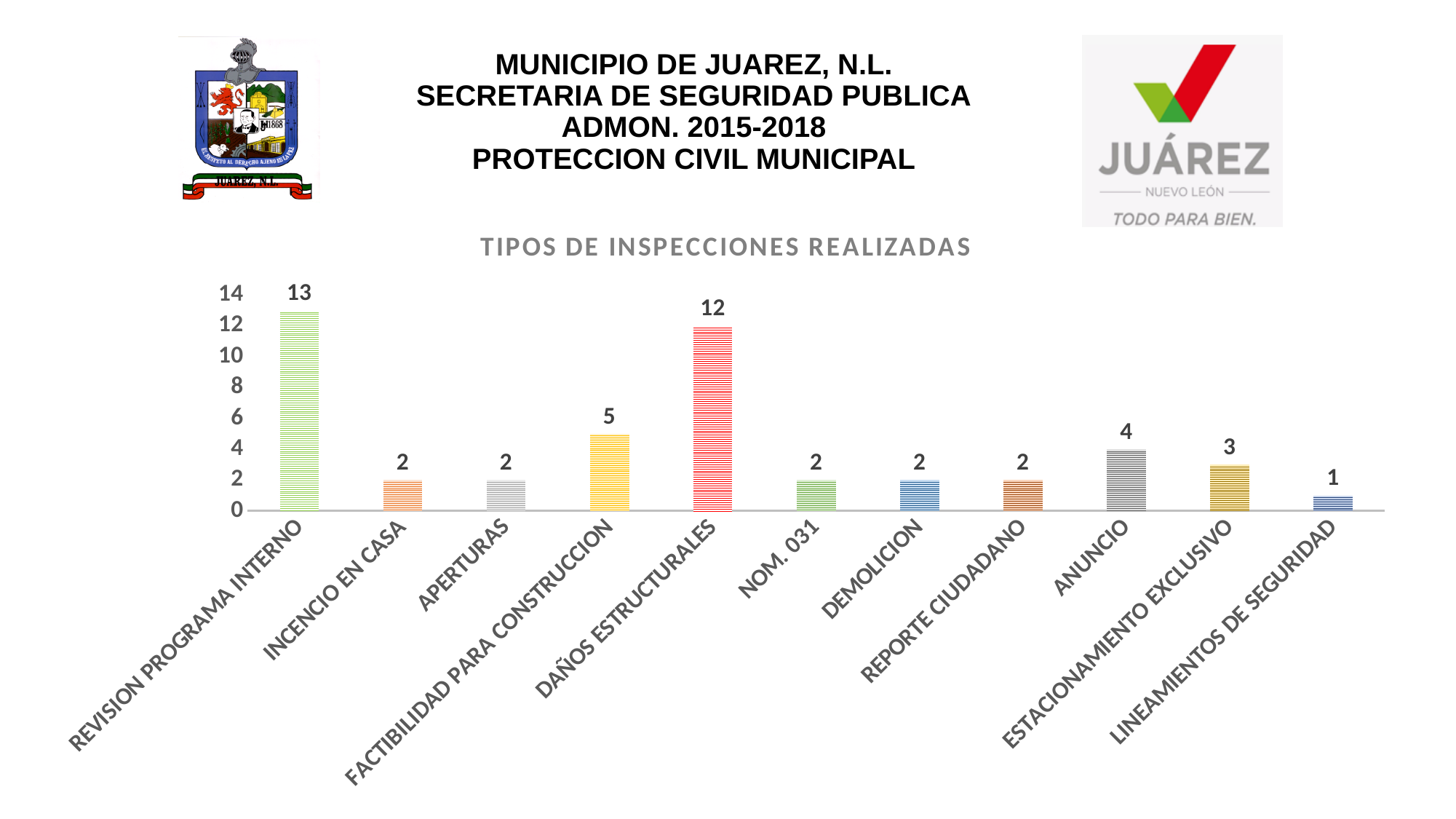
Which category has the lowest value? LINEAMIENTOS DE SEGURIDAD What is the value for REVISION PROGRAMA INTERNO? 13 Which is larger, the value for ESTACIONAMIENTO EXCLUSIVO or the value for FACTIBILIDAD PARA CONSTRUCCION? FACTIBILIDAD PARA CONSTRUCCION What is the value for DAÑOS ESTRUCTURALES? 12 What is the value for FACTIBILIDAD PARA CONSTRUCCION? 5 What is the title of the chart? TIPOS DE INSPECCIONES REALIZADAS What kind of chart is shown on the slide? bar chart How many categories are shown on the x axis? 11 Is the value for DAÑOS ESTRUCTURALES greater or less than 10? greater Which category has the highest value? REVISION PROGRAMA INTERNO What is the value for ANUNCIO? 4 What is the difference between the values for REVISION PROGRAMA INTERNO and DAÑOS ESTRUCTURALES? 1